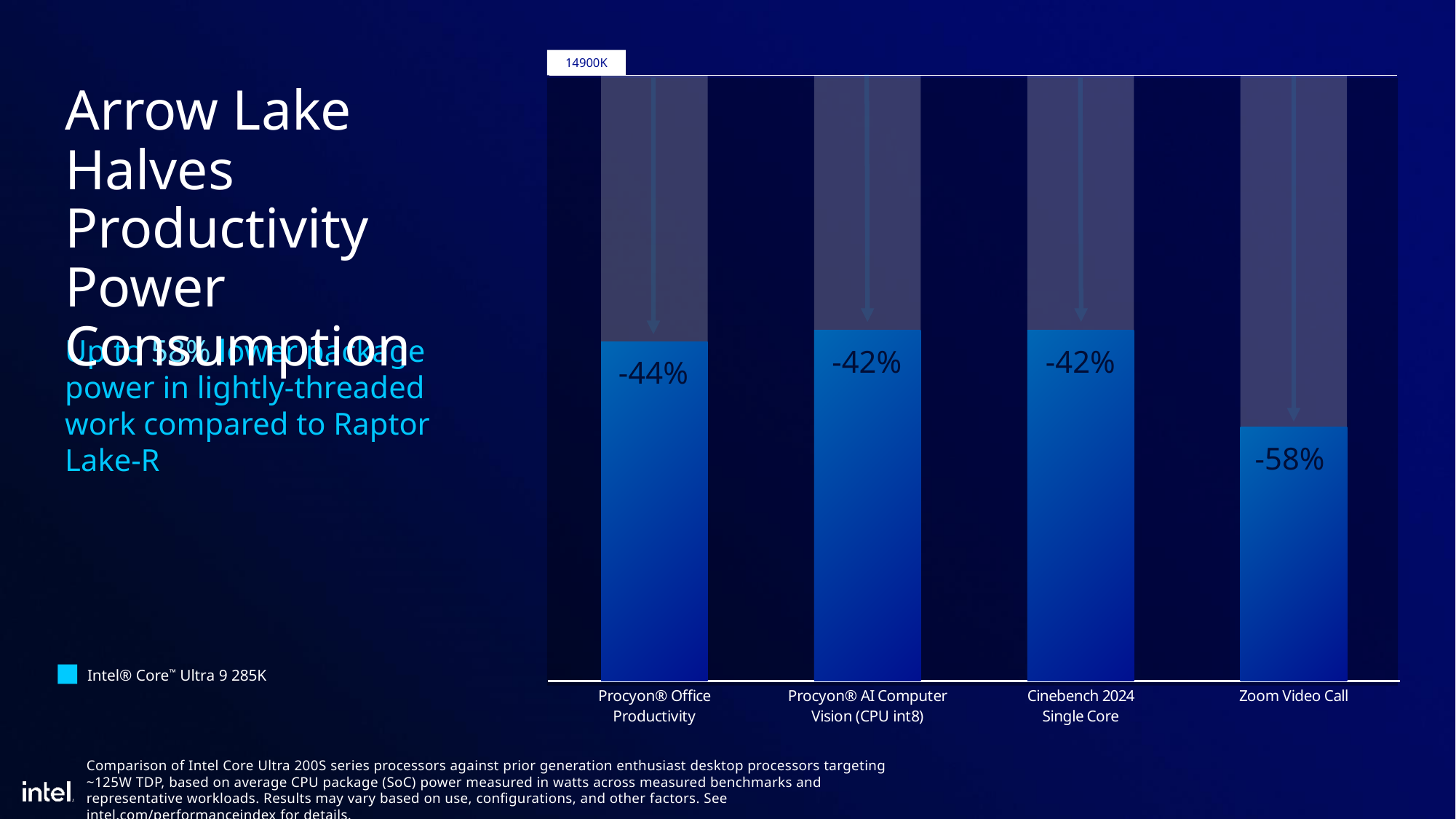
Which processor does the legend entry on the slide name? Intel® Core™ Ultra 9 285K What kind of chart is shown on the slide? Bar chart Which has the larger value, Procyon® Office Productivity or Zoom Video Call? Procyon® Office Productivity What is the difference in percentage points between the Procyon® Office Productivity value and the Zoom Video Call value? 14 percentage points What is the value shown for Procyon® AI Computer Vision (CPU int8)? -42% Which category shows the largest power reduction (the lowest value)? Zoom Video Call Which processor is labelled as the baseline at the top of the chart? 14900K What is the difference in percentage points between the Cinebench 2024 Single Core value and the Zoom Video Call value? 16 percentage points How many categories are shown on the x axis of the chart? 4 What is the value shown for Procyon® Office Productivity? -44% What is the value shown for Zoom Video Call? -58% What is the value shown for Cinebench 2024 Single Core? -42%